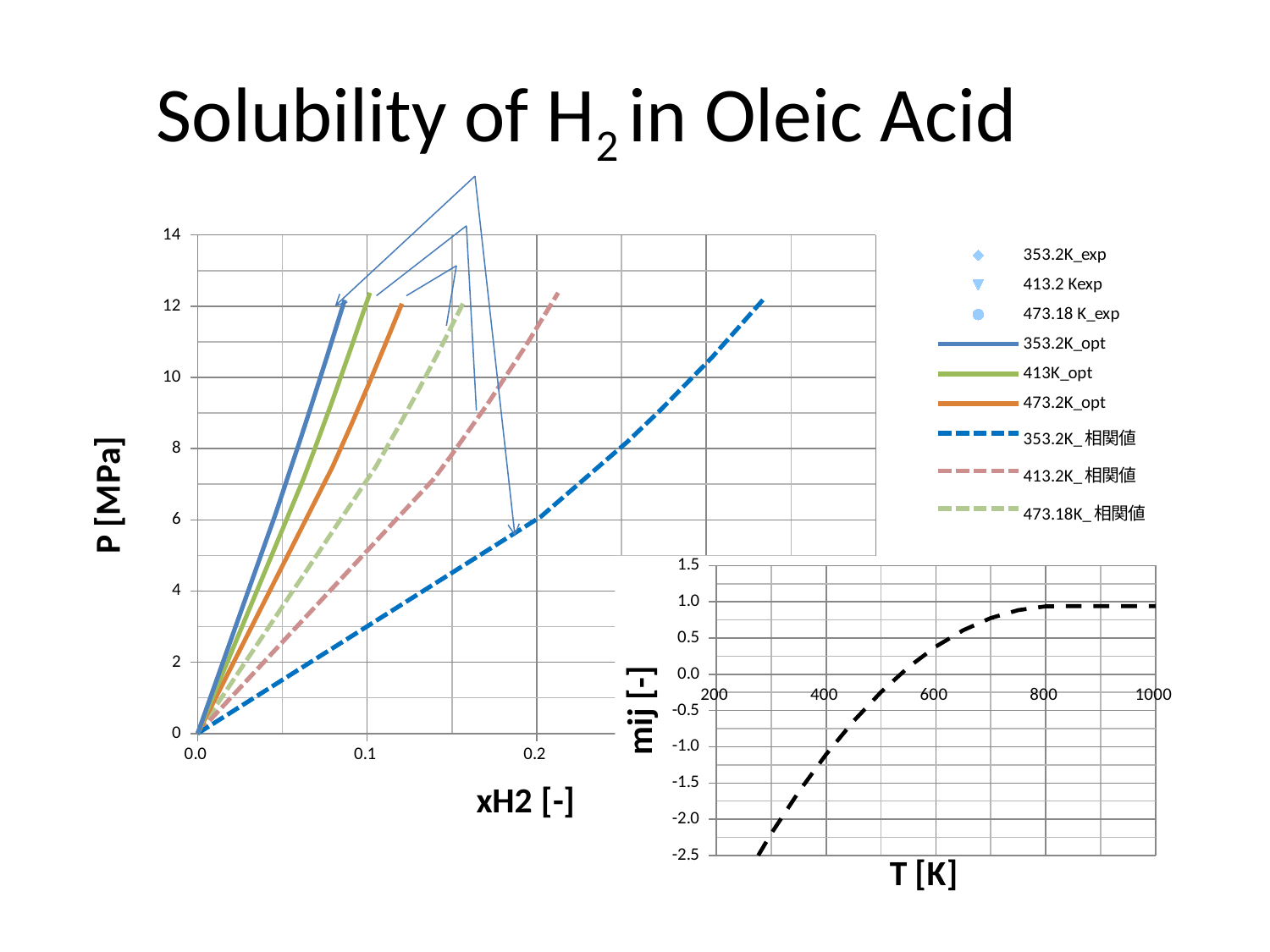
In the bottom-right chart, is the value of mij at T = 400 K greater or less than 0.0? less What kind of chart is the smaller chart at the bottom right of the slide? line chart What kind of chart is the large chart on the left of the slide? line chart In the left chart, do the plotted lines rise or fall as xH2 increases? rise What is the y-axis label of the left chart? P [MPa] How many series does the legend of the left chart list? 9 In the left chart, is the value of the 353.2K_相関値 line at xH2 = 0.1 greater or less than 4 MPa? less In the bottom-right chart, does mij rise or fall as T increases from 200 K to 800 K? rise In the left chart, which series extends to the largest xH2 value? 353.2K_相関値 In the left chart, at xH2 = 0.1, which line is higher: 413K_opt or 473.2K_opt? 413K_opt What is the x-axis label of the left chart? xH2 [-] In the bottom-right chart, is the value of mij at T = 800 K greater or less than 0.5? greater